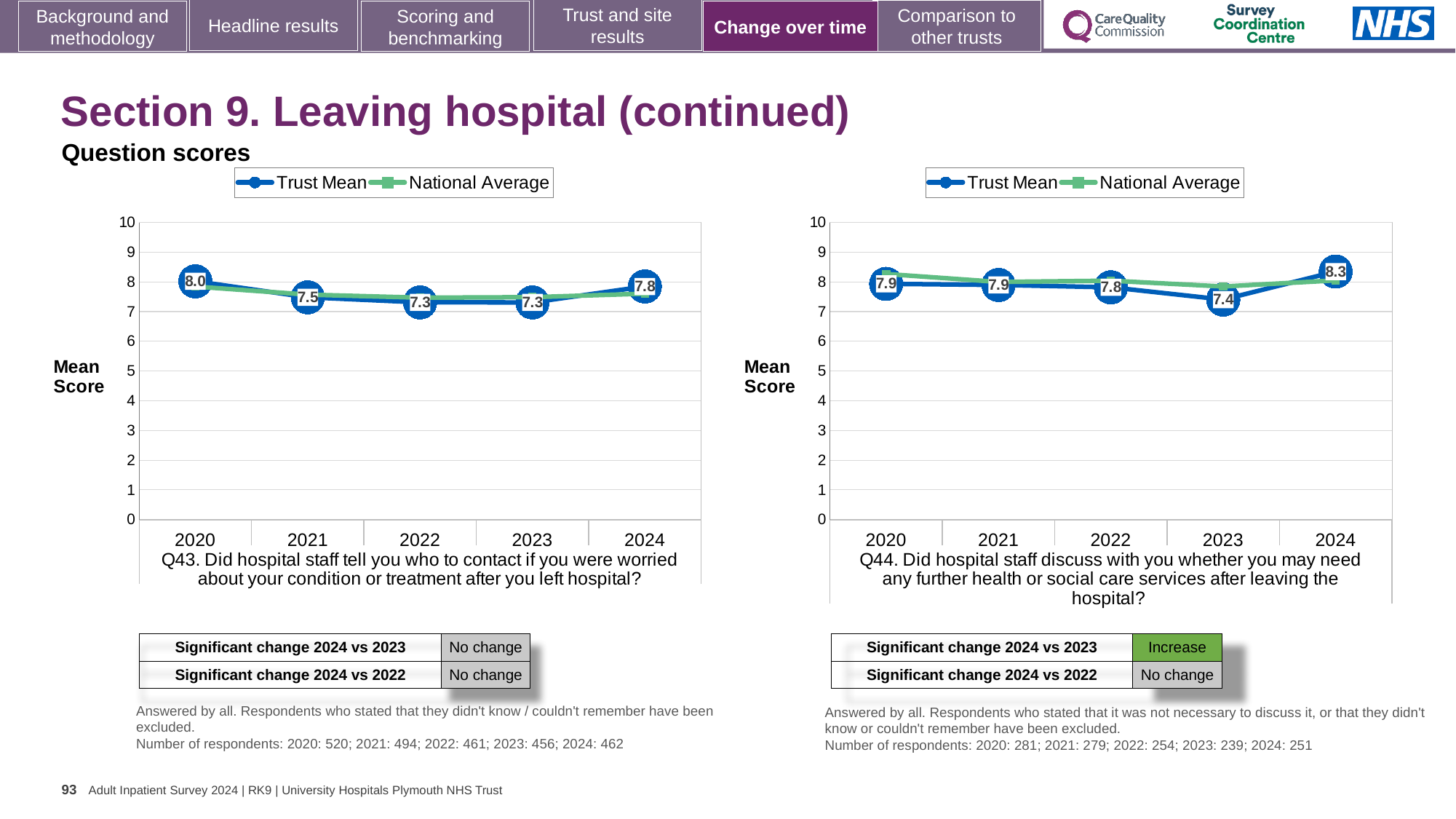
On the Q44 chart, is the Trust Mean score for 2024 greater or less than the Trust Mean score for 2020? greater On the Q43 chart, which year has the highest Trust Mean score? 2020 On the Q44 chart, what is the Trust Mean score for 2024? 8.3 On the Q43 chart, what is the Trust Mean score for 2024? 7.8 What type of chart is the Q43 chart? Line chart On the Q43 chart, how many years are plotted on the x axis? 5 On the Q44 chart, what is the Trust Mean score for 2023? 7.4 How many series does the legend of the Q44 chart list? 2 On the Q44 chart, what is the difference between the Trust Mean scores for 2024 and 2023? 0.9 On the Q44 chart, which year has the lowest Trust Mean score? 2023 On the Q43 chart, what is the difference between the Trust Mean scores for 2020 and 2022? 0.7 On the Q43 chart, what is the Trust Mean score for 2020? 8.0